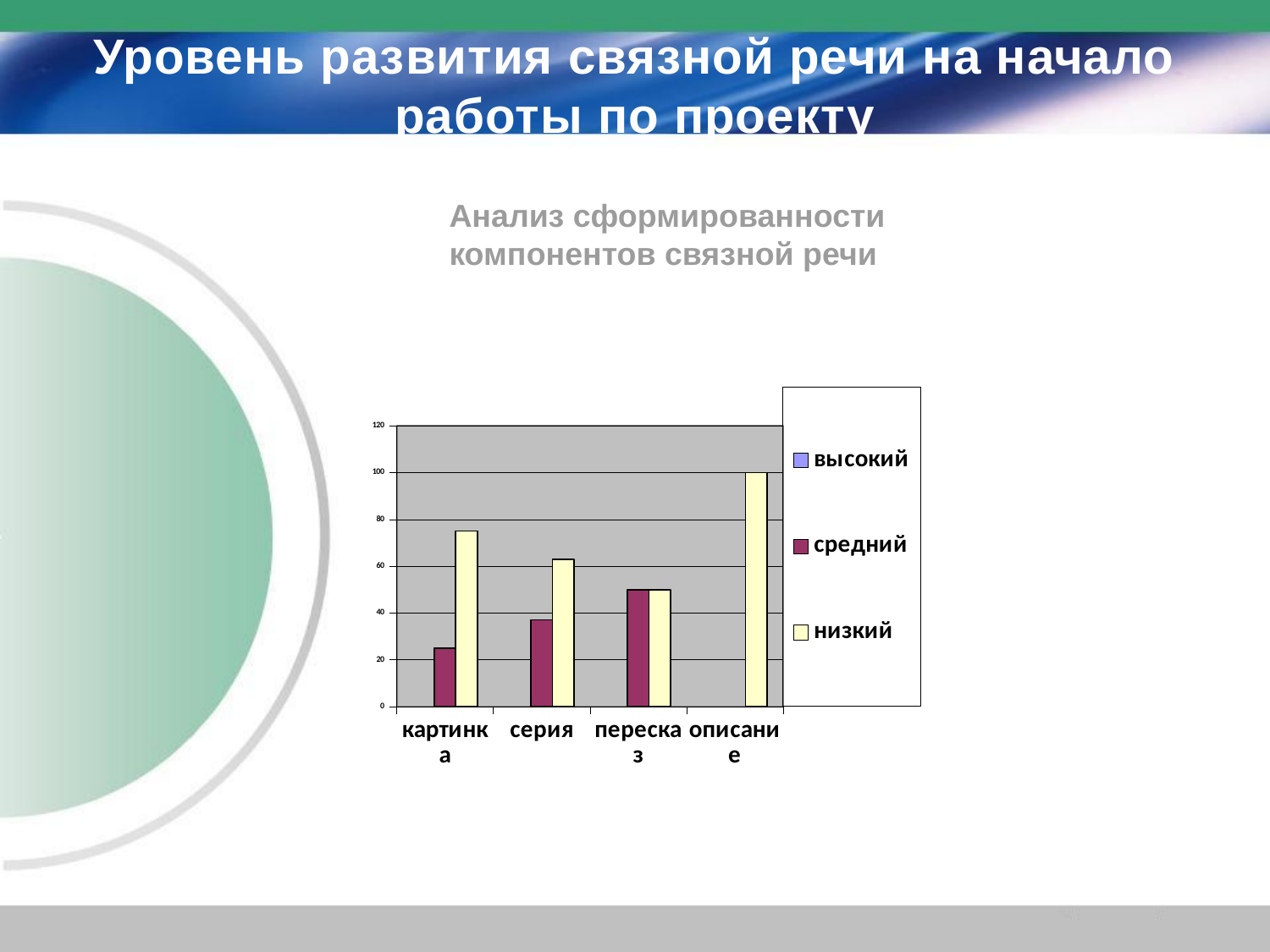
What is the title of the chart? Анализ сформированности компонентов связной речи Is the value of низкий for картинка greater or less than 60? greater Is the value of средний for серия greater or less than 20? greater Is the value of средний for картинка greater or less than 40? less Which category has the lowest value for низкий? пересказ For картинка, which is larger: средний or низкий? низкий What kind of chart is shown on the slide? bar chart Which category has the highest value for низкий? описание What is the value of низкий for описание? 100 How many categories are shown on the x axis? 4 How many series does the legend list? 3 Which category has the highest value for средний? пересказ